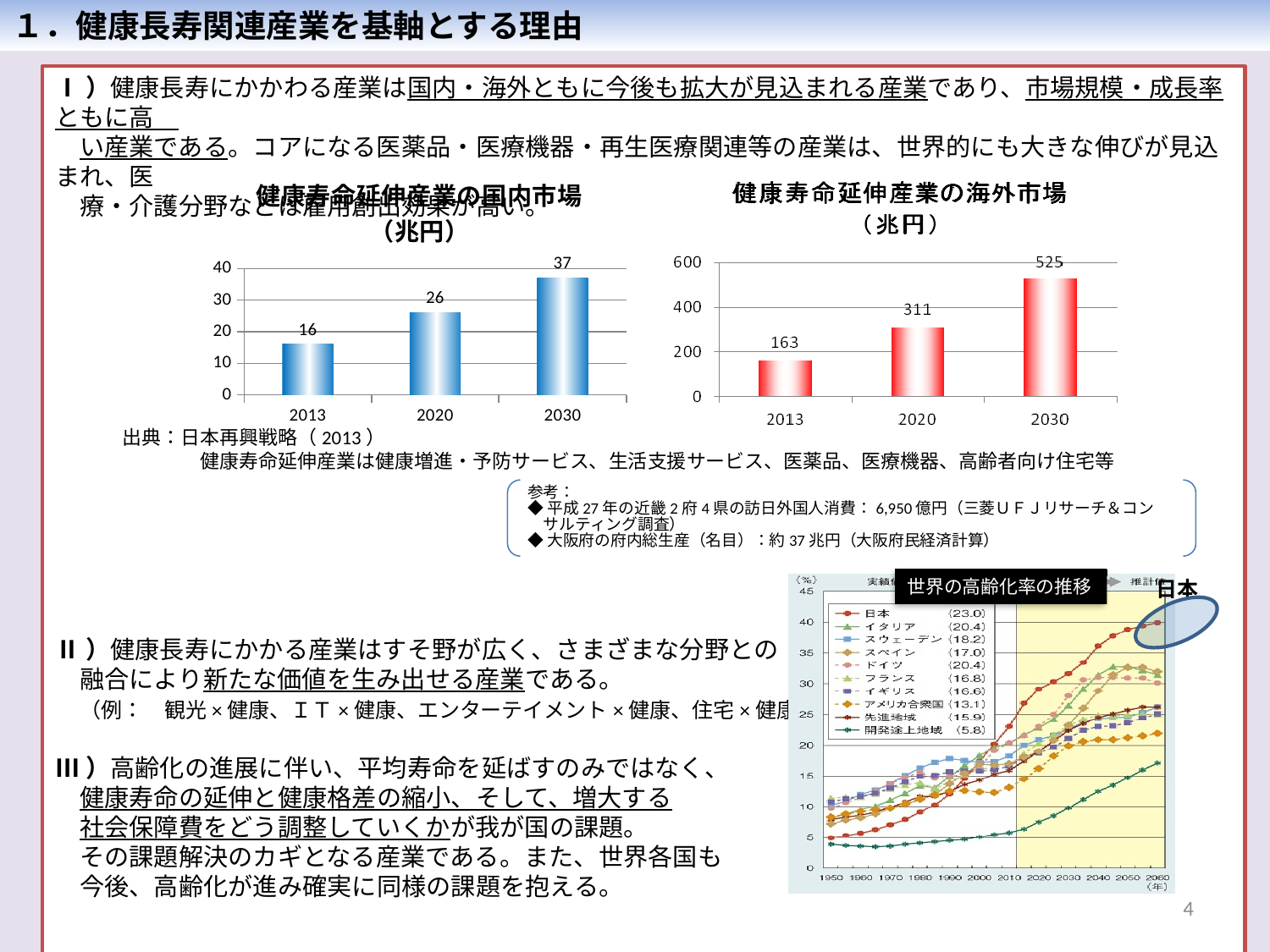
In the right bar chart (健康寿命延伸産業の海外市場), what is the difference between the 2030 and 2013 values? 362 In the right bar chart (健康寿命延伸産業の海外市場), which year has the highest value? 2030 In the left bar chart (健康寿命延伸産業の国内市場), which year has the lowest value? 2013 In the right bar chart (健康寿命延伸産業の海外市場), do the values rise or fall from 2013 to 2030? rise How many bars are in the left bar chart (健康寿命延伸産業の国内市場)? 3 In the right bar chart (健康寿命延伸産業の海外市場), is the value for 2020 greater or less than 400? less In the left bar chart (健康寿命延伸産業の国内市場), what is the difference between the 2020 and 2013 values? 10 In the left bar chart (健康寿命延伸産業の国内市場), what is the value for 2030? 37 What kind of chart is the right chart titled 健康寿命延伸産業の海外市場? bar chart In the right bar chart (健康寿命延伸産業の海外市場), what is the value for 2020? 311 In the left bar chart (健康寿命延伸産業の国内市場), what is the value for 2013? 16 What unit is shown in the title of the left bar chart (健康寿命延伸産業の国内市場)? 兆円